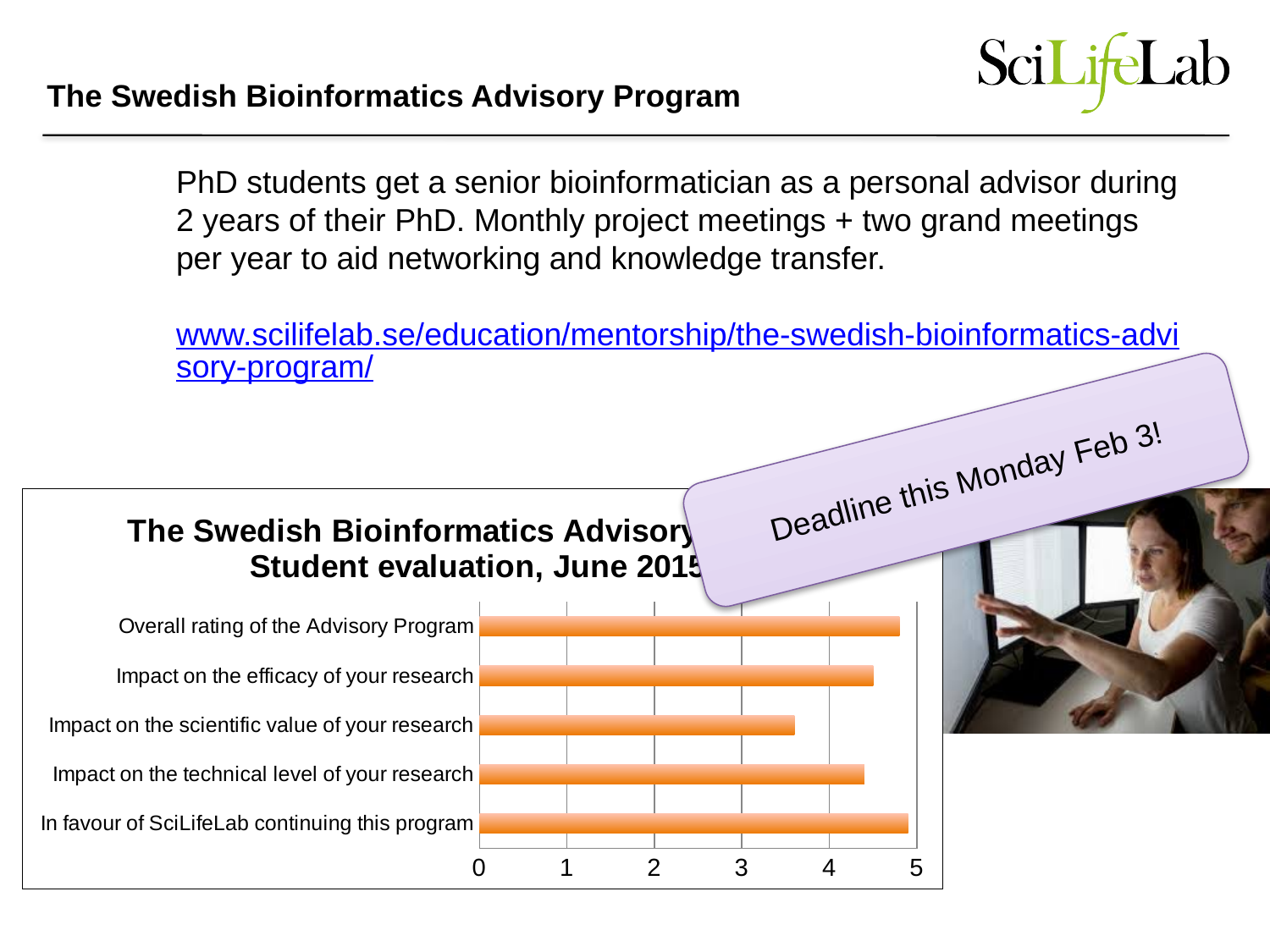
Is the value for 'Impact on the efficacy of your research' greater or less than 4? greater Which is larger: the value for 'Impact on the technical level of your research' or 'Impact on the scientific value of your research'? Impact on the technical level of your research Which is larger: the value for 'Impact on the efficacy of your research' or 'Impact on the scientific value of your research'? Impact on the efficacy of your research Is the value for 'Overall rating of the Advisory Program' greater or less than 4? greater Is the value for 'Impact on the technical level of your research' greater or less than 3? greater What kind of chart is shown on the slide? bar chart Which category has the lowest value in the chart? Impact on the scientific value of your research How many categories are plotted in the chart? 5 What is the highest value shown on the chart's horizontal axis? 5 What colour are the bars in the chart? orange